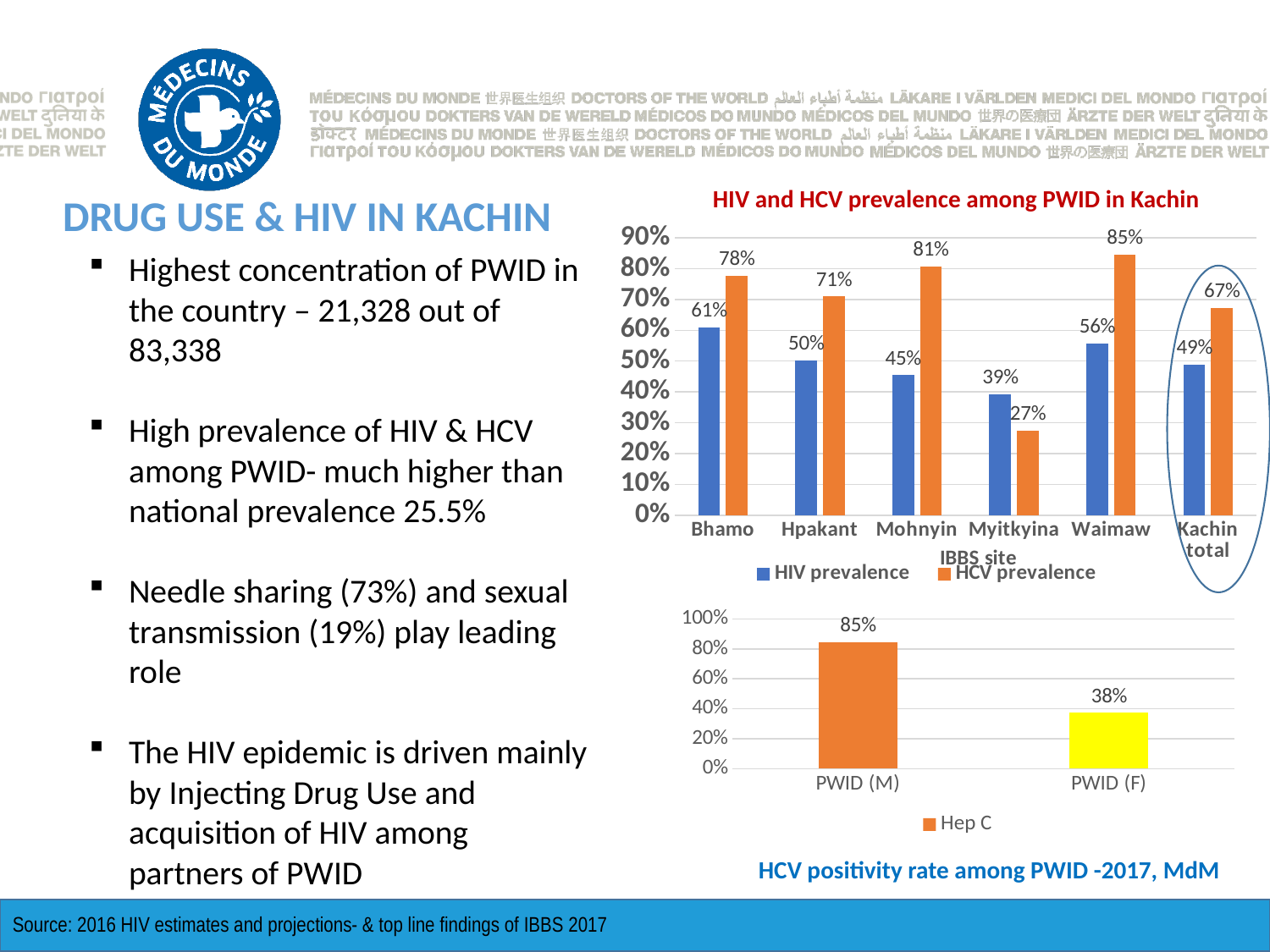
In the 'HIV and HCV prevalence among PWID in Kachin' chart, what is the HCV prevalence for Mohnyin? 81% In the 'HCV positivity rate among PWID -2017, MdM' chart, what is the value for PWID (F)? 38% How many IBBS site categories are shown in the 'HIV and HCV prevalence among PWID in Kachin' chart? 6 How many series does the legend of the 'HIV and HCV prevalence among PWID in Kachin' chart list? 2 In the 'HIV and HCV prevalence among PWID in Kachin' chart, what is the HCV prevalence for Kachin total? 67% In the 'HIV and HCV prevalence among PWID in Kachin' chart, which IBBS site has the lowest HIV prevalence? Myitkyina In the 'HIV and HCV prevalence among PWID in Kachin' chart, which IBBS site has the highest HCV prevalence? Waimaw In the 'HCV positivity rate among PWID -2017, MdM' chart, what is the difference between PWID (M) and PWID (F)? 47% In the 'HIV and HCV prevalence among PWID in Kachin' chart, what is the HIV prevalence for Bhamo? 61% What type of chart is the 'HCV positivity rate among PWID -2017, MdM' chart? Bar chart In the 'HIV and HCV prevalence among PWID in Kachin' chart, which is larger for Myitkyina: HIV prevalence or HCV prevalence? HIV prevalence In the 'HIV and HCV prevalence among PWID in Kachin' chart, what is the difference between HCV prevalence and HIV prevalence for Hpakant? 21%